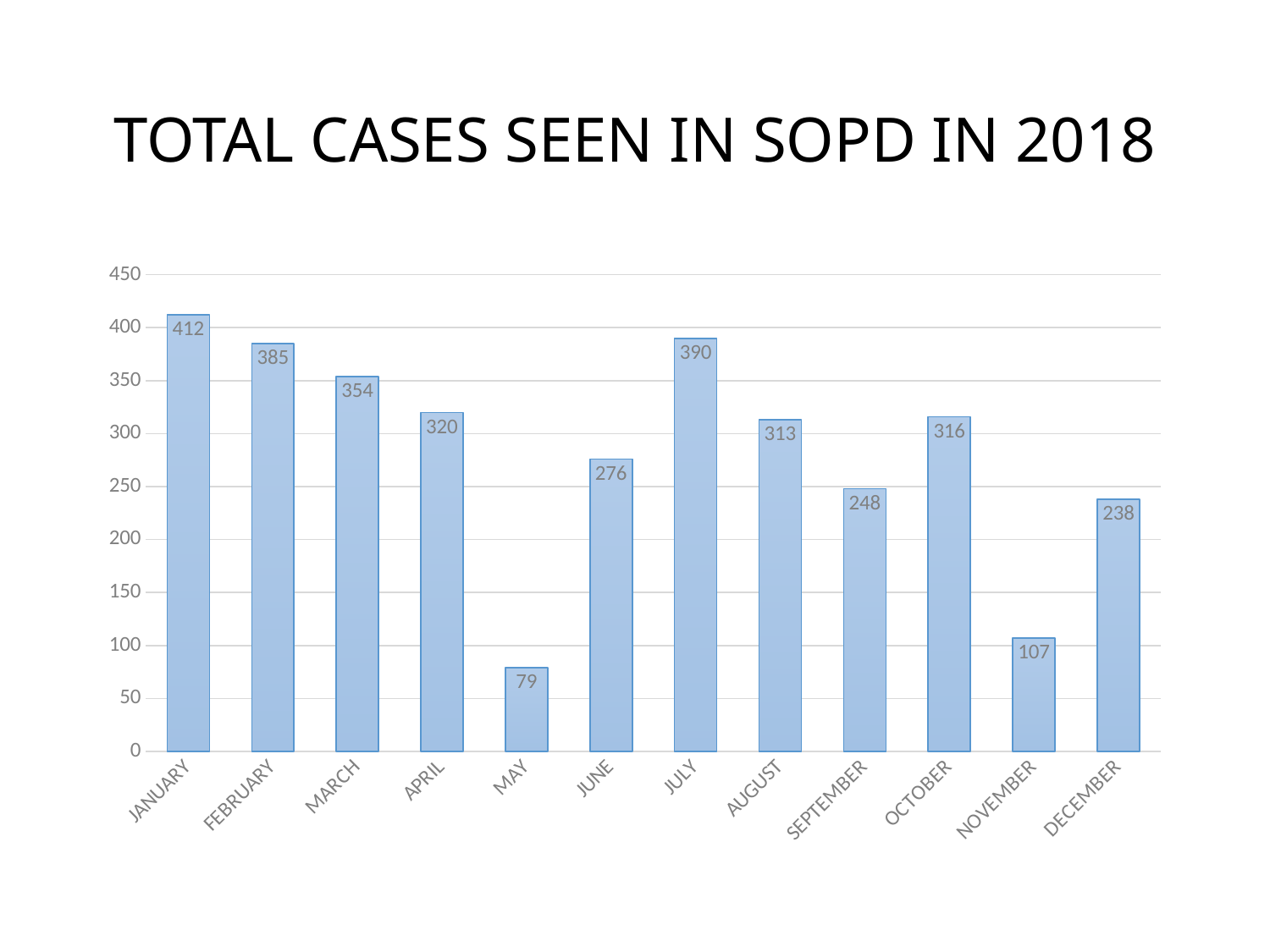
What is the value for MAY? 79 Is the value for JUNE greater or less than 250? greater Which month has the lowest value? MAY What kind of chart is shown on the slide? bar chart What is the value for DECEMBER? 238 What is the title of the chart? TOTAL CASES SEEN IN SOPD IN 2018 Which is larger, the value for MARCH or the value for APRIL? MARCH What is the difference between the values for JULY and NOVEMBER? 283 What is the value for OCTOBER? 316 How many months are shown on the x axis? 12 Which month has the highest value? JANUARY What is the difference between the values for JANUARY and FEBRUARY? 27